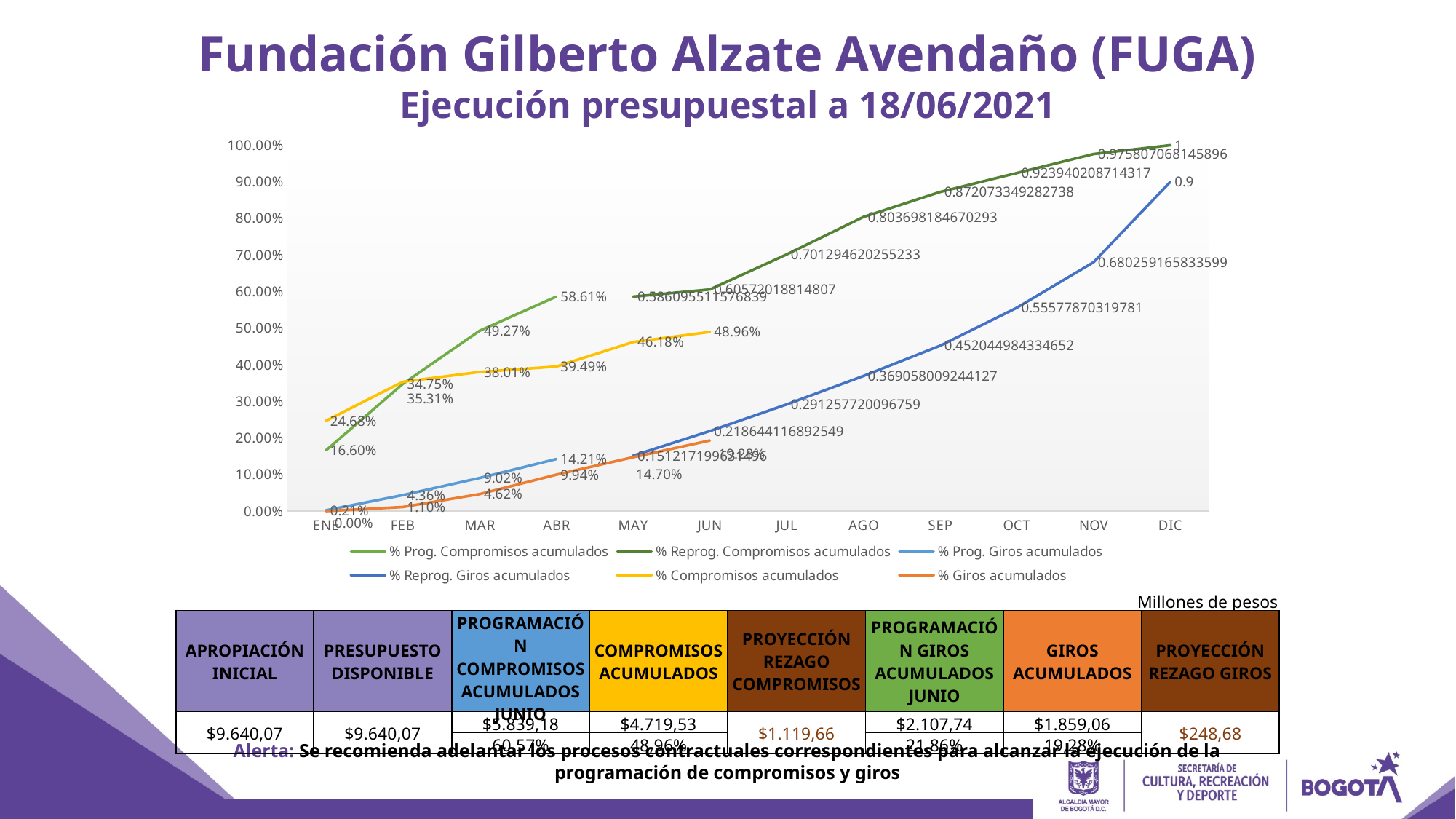
How many series does the chart legend list? 6 What is the value of % Reprog. Giros acumulados in DIC? 0.9 What is the value of % Prog. Compromisos acumulados in ABR? 58.61% What is the value of % Compromisos acumulados in JUN? 48.96% Does the % Giros acumulados line rise or fall from ENE to JUN? rise How many months are shown along the x axis of the chart? 12 What is the value of % Prog. Giros acumulados in MAR? 9.02% In ABR, which is larger: % Prog. Compromisos acumulados or % Compromisos acumulados? % Prog. Compromisos acumulados What is the difference between the % Compromisos acumulados value in JUN and in ENE? 24.28% What kind of chart is shown on the slide? line chart Is the value for % Reprog. Giros acumulados in NOV greater or less than 60.00%? greater What is the value of % Giros acumulados in JUN? 19.28%